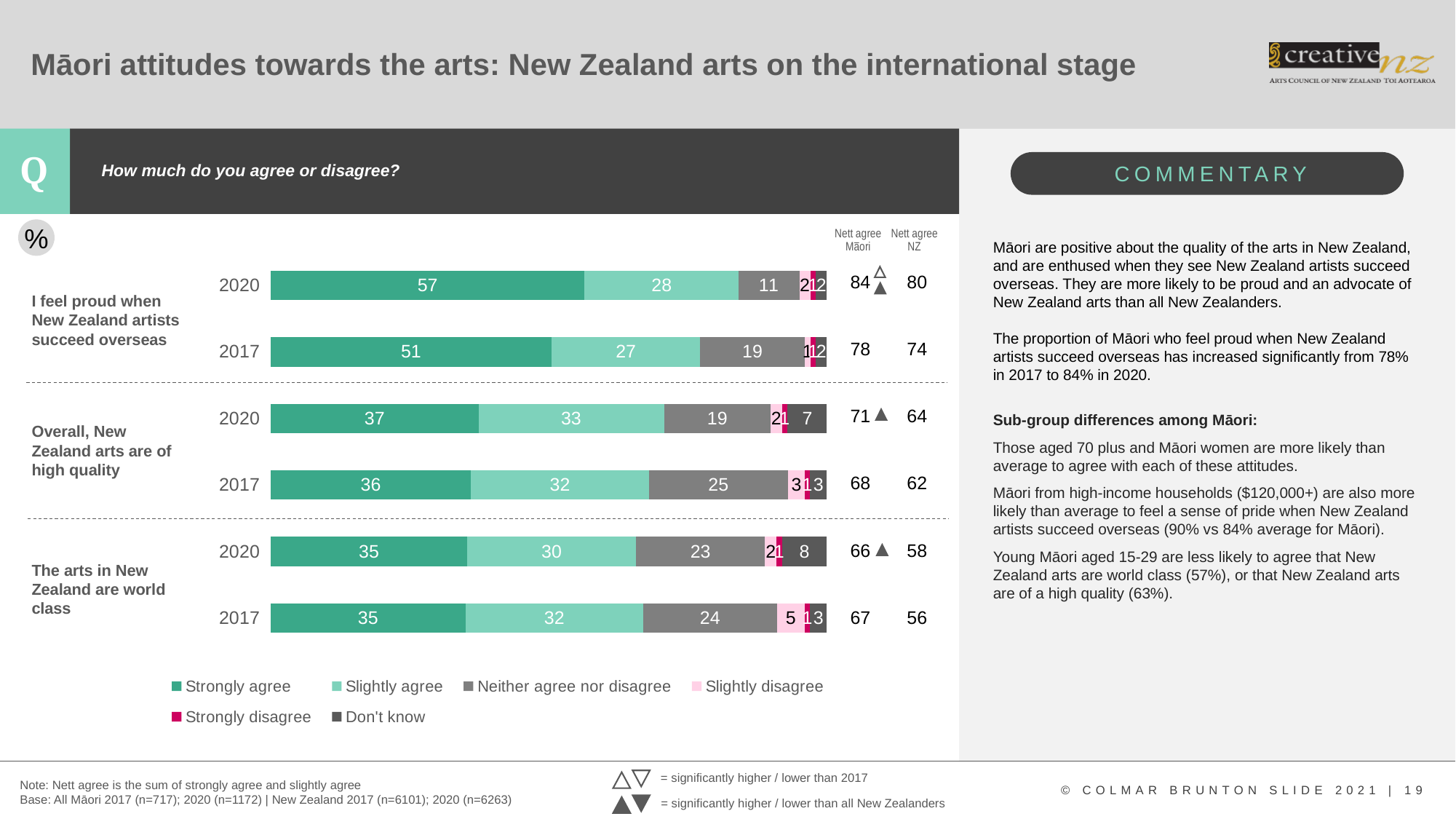
How many bars are shown in the chart? 6 How many series does the legend list? 6 What is the Neither agree nor disagree value for "The arts in New Zealand are world class" in 2020? 23 What is the Slightly agree value for "Overall, New Zealand arts are of high quality" in 2017? 32 What is the Nett agree Māori figure for "I feel proud when New Zealand artists succeed overseas" in 2020? 84 By how many points did Strongly agree for "I feel proud when New Zealand artists succeed overseas" increase from 2017 to 2020? 6 What kind of chart is shown on the slide? Stacked bar chart What percentage of Māori strongly agree with "I feel proud when New Zealand artists succeed overseas" in 2020? 57 Which bar has the highest Strongly agree value? I feel proud when New Zealand artists succeed overseas, 2020 What is the Nett agree NZ figure for "The arts in New Zealand are world class" in 2017? 56 For "I feel proud when New Zealand artists succeed overseas", is the Neither agree nor disagree value larger in 2017 or 2020? 2017 What is the difference between Nett agree Māori and Nett agree NZ for "Overall, New Zealand arts are of high quality" in 2020? 7